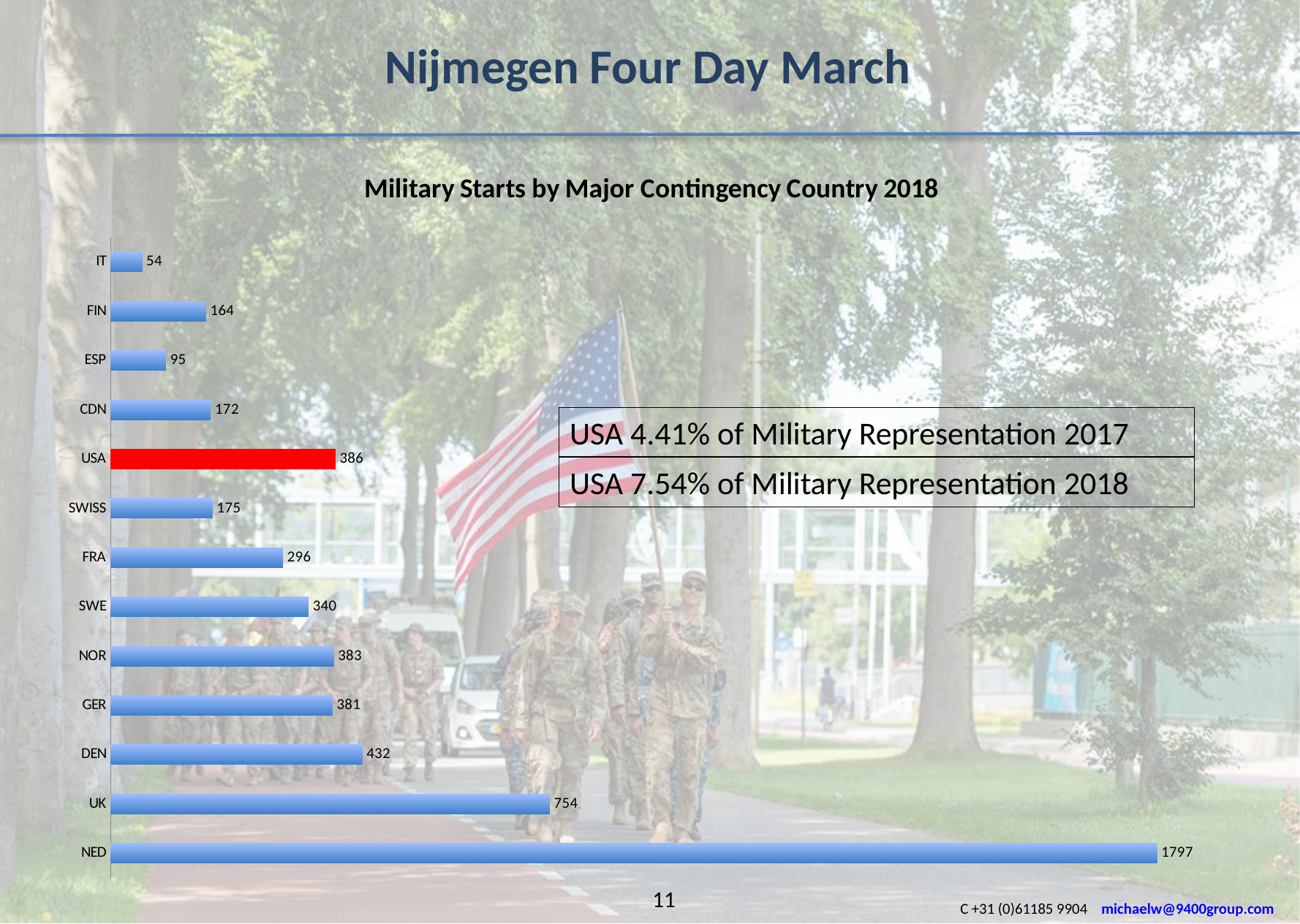
What is the value for CDN? 172 What is the difference between the values for NED and UK? 1043 How many countries are shown in the chart? 13 Which is larger, the value for FRA or the value for SWE? SWE Which country has the highest number of military starts? NED Which country has the lowest number of military starts? IT What is the value for USA in the Military Starts by Major Contingency Country 2018 chart? 386 What is the value for NED? 1797 Which bar is coloured red in the chart? USA What is the difference between the values for UK and DEN? 322 What is the title of the chart? Military Starts by Major Contingency Country 2018 What kind of chart is shown on the slide? Bar chart